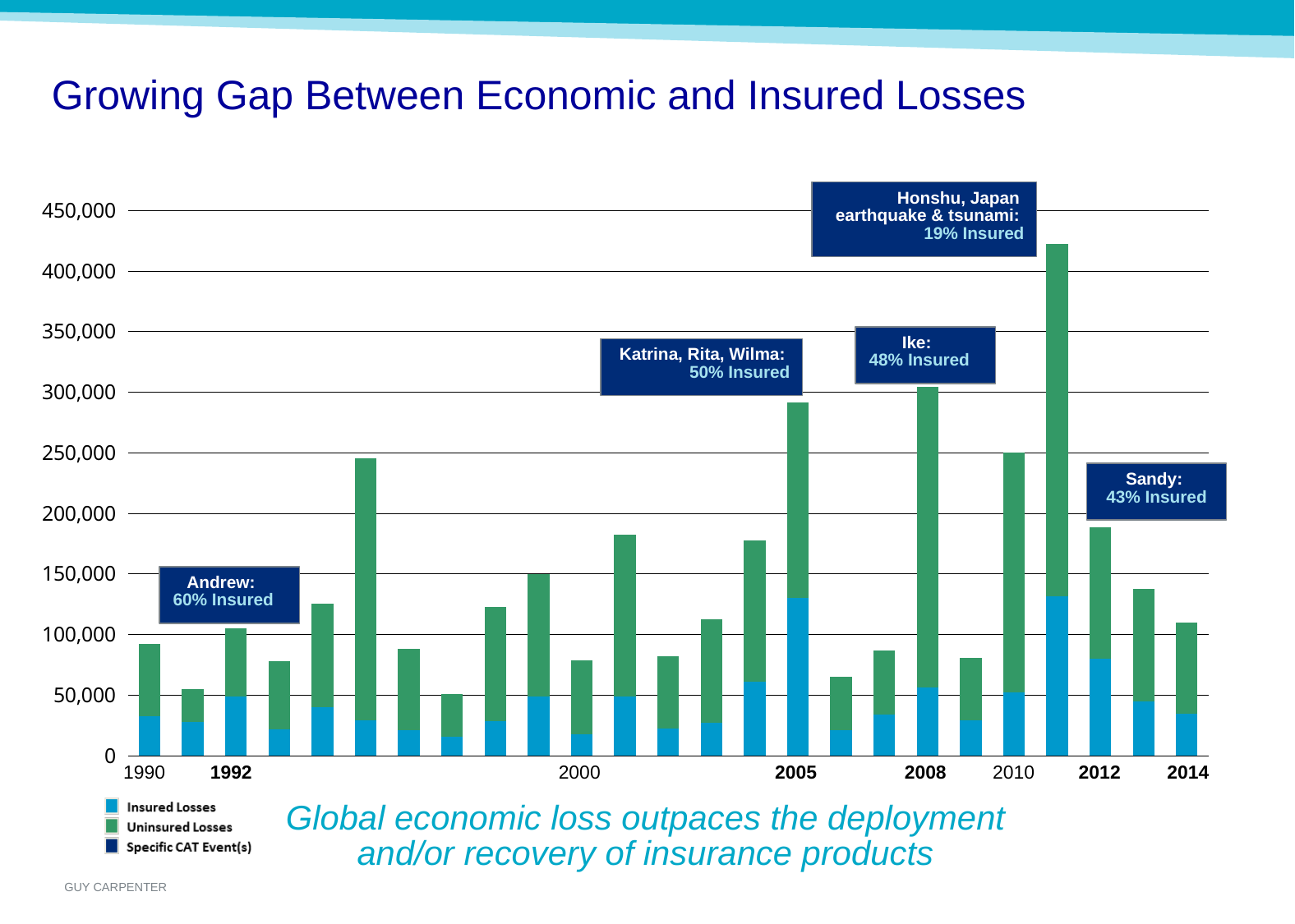
According to the annotation, what percentage of losses from Sandy were insured? 43% Insured According to the annotation, what percentage of losses from the Honshu, Japan earthquake & tsunami were insured? 19% Insured What kind of chart is shown on the slide? Stacked bar chart How many yearly bars are plotted in the chart (1990 through 2014)? 25 Is the total loss bar for 2005 greater or less than 250,000? greater Which year has the taller total loss bar, 2012 or 2014? 2012 How many entries does the chart's legend list? 3 According to the annotation, what percentage of losses from Hurricane Andrew were insured? 60% Insured Is the total loss bar for 2010 greater or less than 200,000? greater Is the total loss bar for 2014 greater or less than 150,000? less Among the annotated catastrophe events, which had the lowest insured percentage? Honshu, Japan earthquake & tsunami What is the title of the chart on the slide? Growing Gap Between Economic and Insured Losses